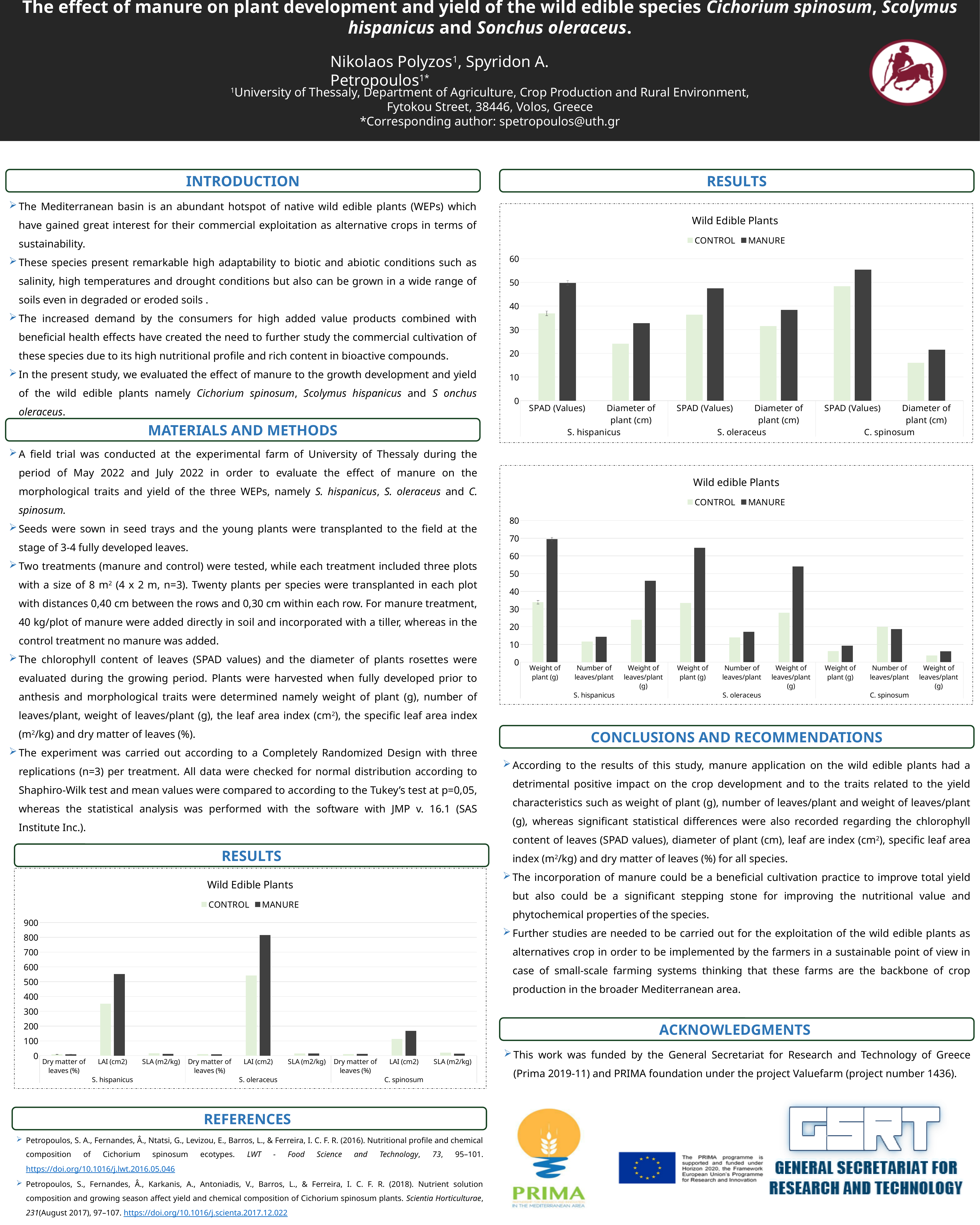
In the middle-right chart (weight of plant, number of leaves, weight of leaves), which bar is the highest? MANURE, Weight of plant (g), S. hispanicus In the bottom-left chart (dry matter, LAI, SLA), is the MANURE value for LAI (cm2) of S. oleraceus greater or less than 700? greater What kind of chart is the top-right chart titled 'Wild Edible Plants' (SPAD and diameter)? bar chart In the middle-right chart (weight of plant, number of leaves, weight of leaves), is the CONTROL value for Weight of leaves/plant (g) of C. spinosum greater or less than 10? less In the top-right chart (SPAD and diameter), how many series does the legend list? 2 In the middle-right chart (weight of plant, number of leaves, weight of leaves), is the MANURE value for Weight of plant (g) of S. oleraceus greater or less than 60? greater In the bottom-left chart (dry matter, LAI, SLA), how many species groups are shown on the x axis? 3 In the top-right chart (SPAD and diameter), which is larger for SPAD (Values) of S. oleraceus, CONTROL or MANURE? MANURE In the bottom-left chart (dry matter, LAI, SLA), which bar is the highest? MANURE, LAI (cm2), S. oleraceus